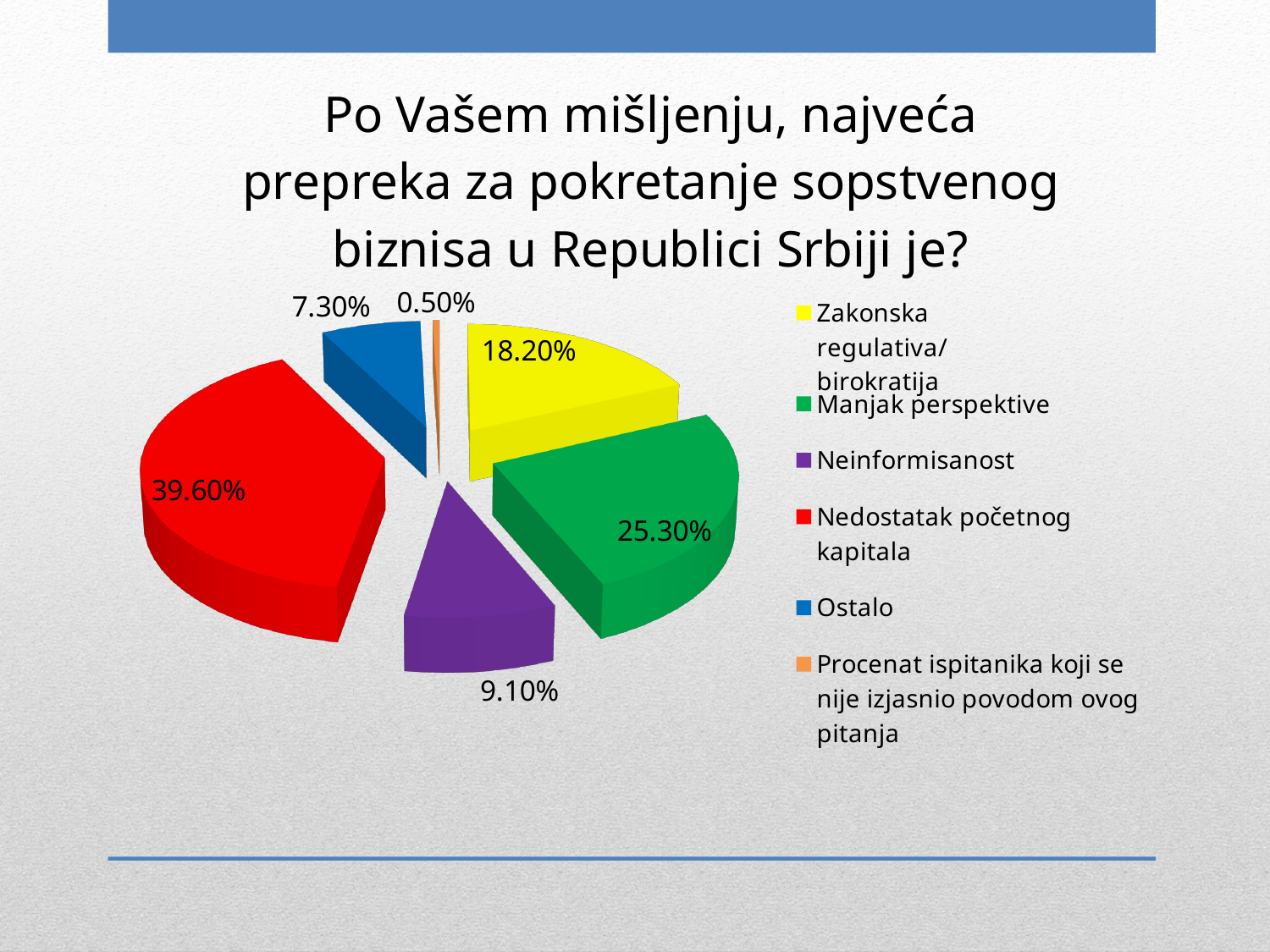
What kind of chart is shown on the slide? Pie chart What colour is the slice for Ostalo? Blue What is the difference in percentage points between Nedostatak početnog kapitala and Manjak perspektive? 14.30% Which is larger, the share for Zakonska regulativa/birokratija or the share for Neinformisanost? Zakonska regulativa/birokratija What percentage is shown for Zakonska regulativa/birokratija? 18.20% What percentage is shown for Manjak perspektive? 25.30% What percentage is shown for Neinformisanost? 9.10% How many slices does the pie chart have? 6 Which category has the largest share of the pie? Nedostatak početnog kapitala Which category has the smallest share of the pie? Procenat ispitanika koji se nije izjasnio povodom ovog pitanja What percentage is shown for Nedostatak početnog kapitala? 39.60% What percentage is shown for Ostalo? 7.30%